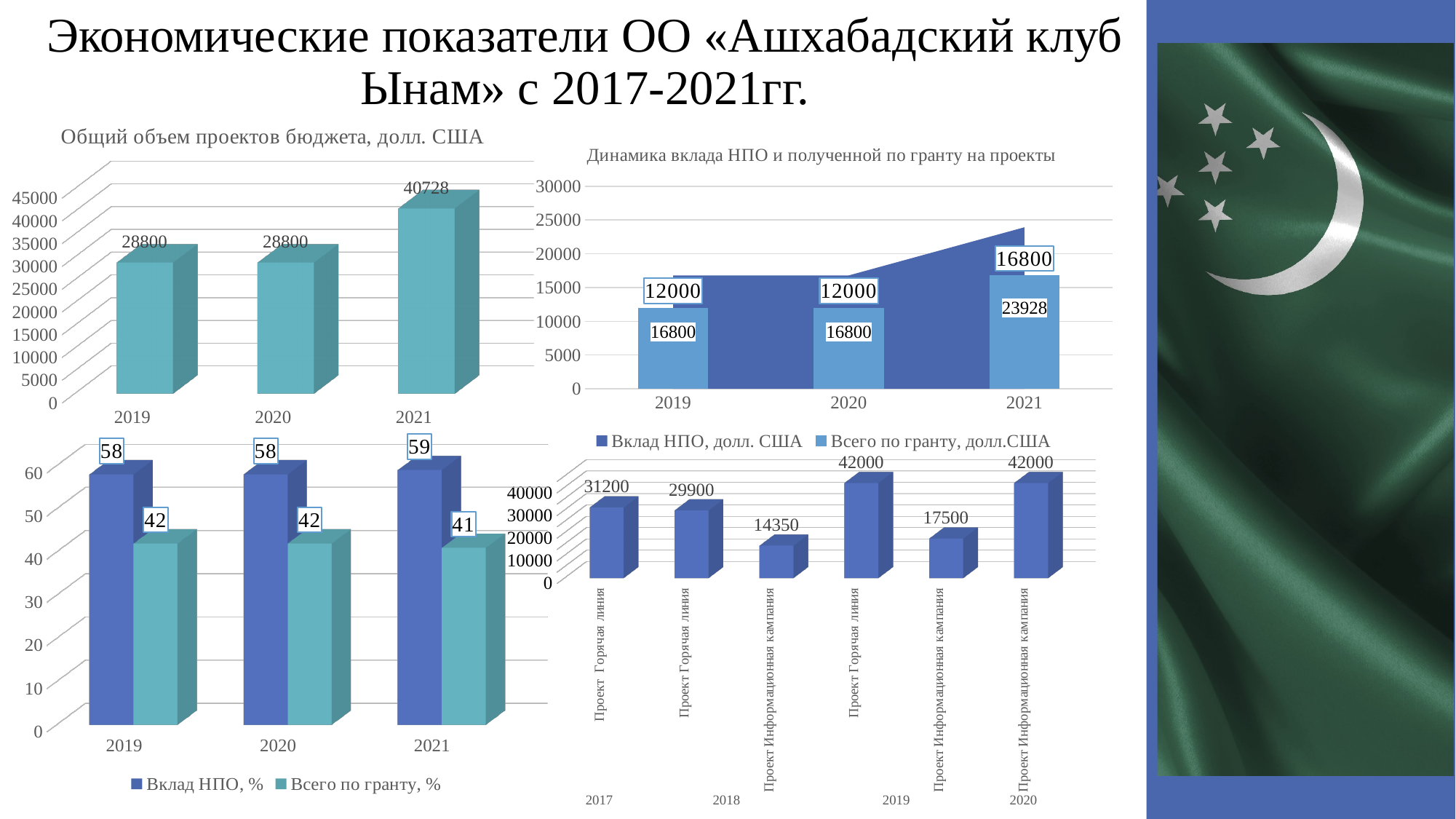
In the bottom-right chart of project budgets, what is the value for «Проект Информационная кампания» in 2019? 17500 In the chart titled «Динамика вклада НПО и полученной по гранту на проекты», what is the value of «Всего по гранту, долл.США» for 2021? 16800 In the chart titled «Общий объем проектов бюджета, долл. США», how many years are shown? 3 In the chart titled «Общий объем проектов бюджета, долл. США», what is the value for 2021? 40728 In the bottom-right chart of project budgets, how many bars are shown? 6 In the bottom-left chart with the legend «Вклад НПО, %» and «Всего по гранту, %», what is the difference between «Вклад НПО, %» and «Всего по гранту, %» in 2021? 18 In the chart titled «Общий объем проектов бюджета, долл. США», what is the difference between the 2021 value and the 2020 value? 11928 In the chart titled «Динамика вклада НПО и полученной по гранту на проекты», what is the value of «Вклад НПО, долл. США» for 2021? 23928 In the chart titled «Динамика вклада НПО и полученной по гранту на проекты», how many series does the legend list? 2 In the chart titled «Общий объем проектов бюджета, долл. США», which year has the highest value? 2021 In the bottom-left chart with the legend «Вклад НПО, %» and «Всего по гранту, %», which is larger for 2019: «Вклад НПО, %» or «Всего по гранту, %»? Вклад НПО, % In the bottom-left chart with the legend «Вклад НПО, %» and «Всего по гранту, %», what is the value of «Всего по гранту, %» for 2021? 41